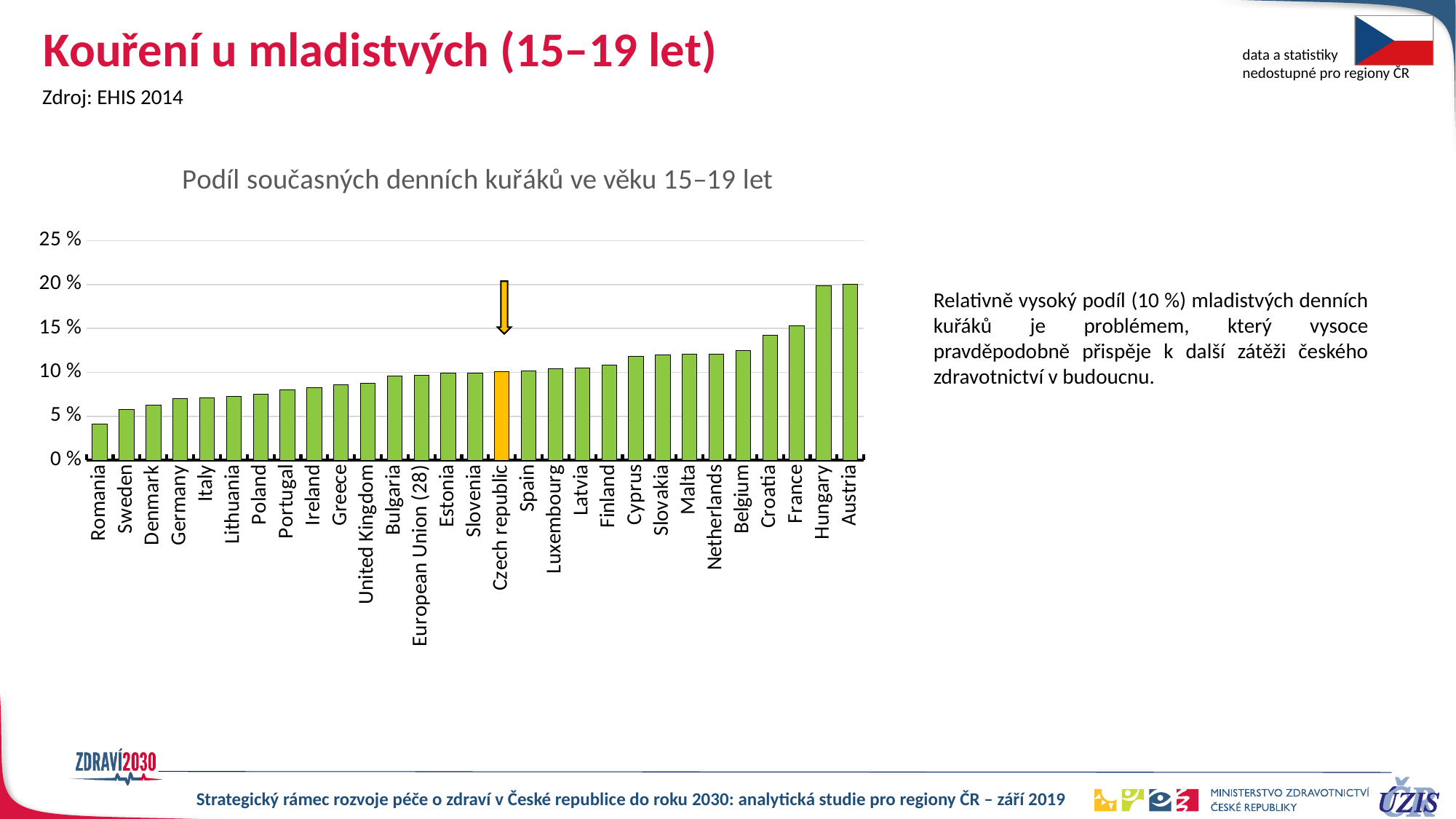
What kind of chart is shown on the slide? bar chart Which has a larger value, Austria or Romania? Austria Is the value for Belgium greater or less than 10 %? greater Which category's bar is highlighted in orange instead of green? Czech republic How many countries/categories are plotted in the chart? 29 Is the value for Croatia greater or less than 15 %? less Do the values generally rise or fall from left to right along the x axis? rise Is the value for Romania greater or less than 5 %? less What is the title of the chart? Podíl současných denních kuřáků ve věku 15–19 let Which category has the lowest value in the chart? Romania